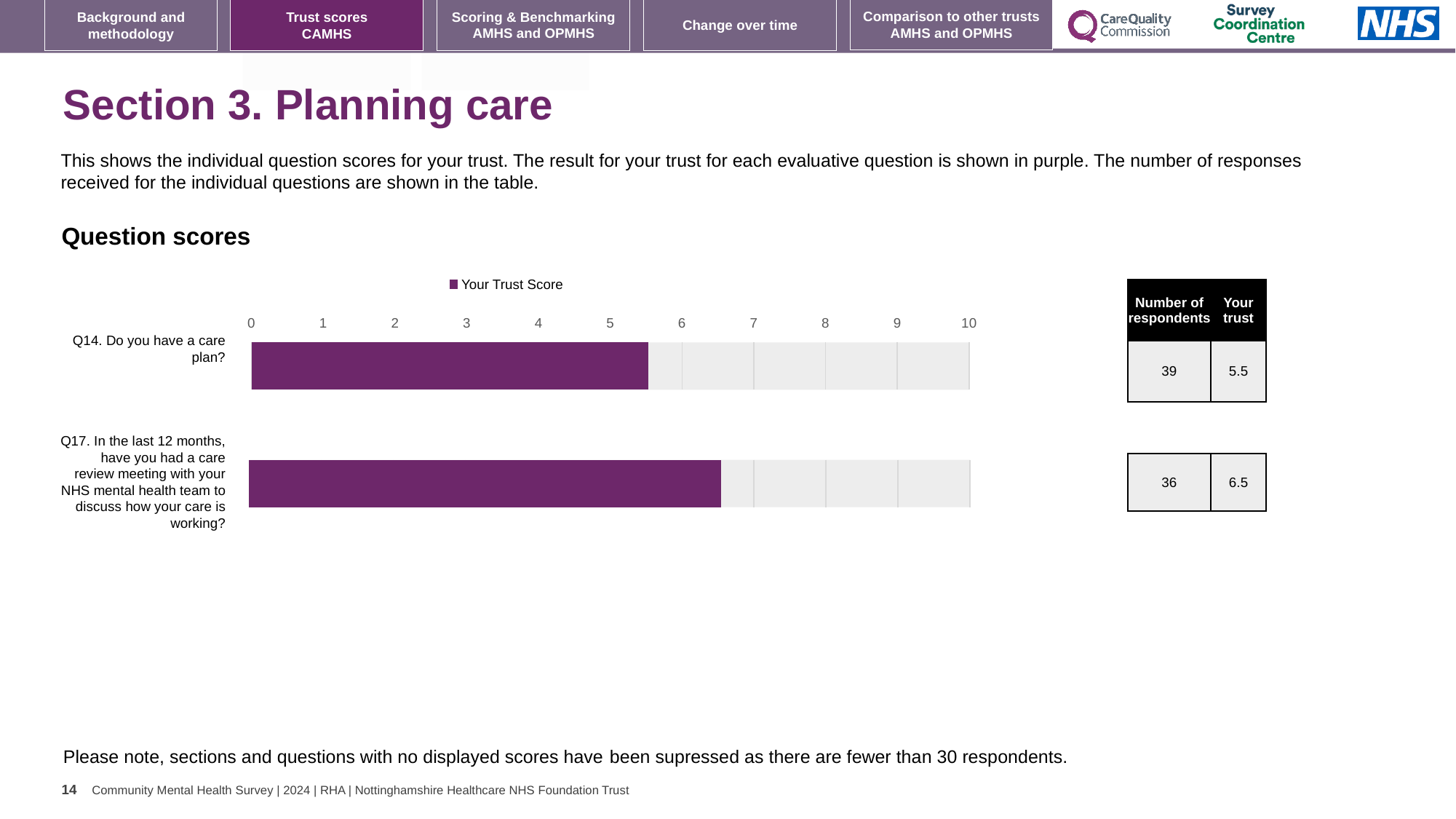
Which question has the lowest trust score on the chart? Q14 What is the trust score for Q14 (Do you have a care plan?) as shown in the table? 5.5 How many questions are plotted on the chart? 2 What is the trust score for Q17 (care review meeting in the last 12 months) as shown in the table? 6.5 How many respondents answered Q17 according to the table? 36 Which question has the higher trust score, Q14 or Q17? Q17 What type of chart is used to show the question scores? Bar chart How many respondents answered Q14 according to the table? 39 Is the trust score for Q14 greater or less than 6? less What is the name of the series shown in the chart legend? Your Trust Score What is the difference between the trust scores for Q17 and Q14? 1.0 Is the trust score for Q17 greater or less than 6? greater